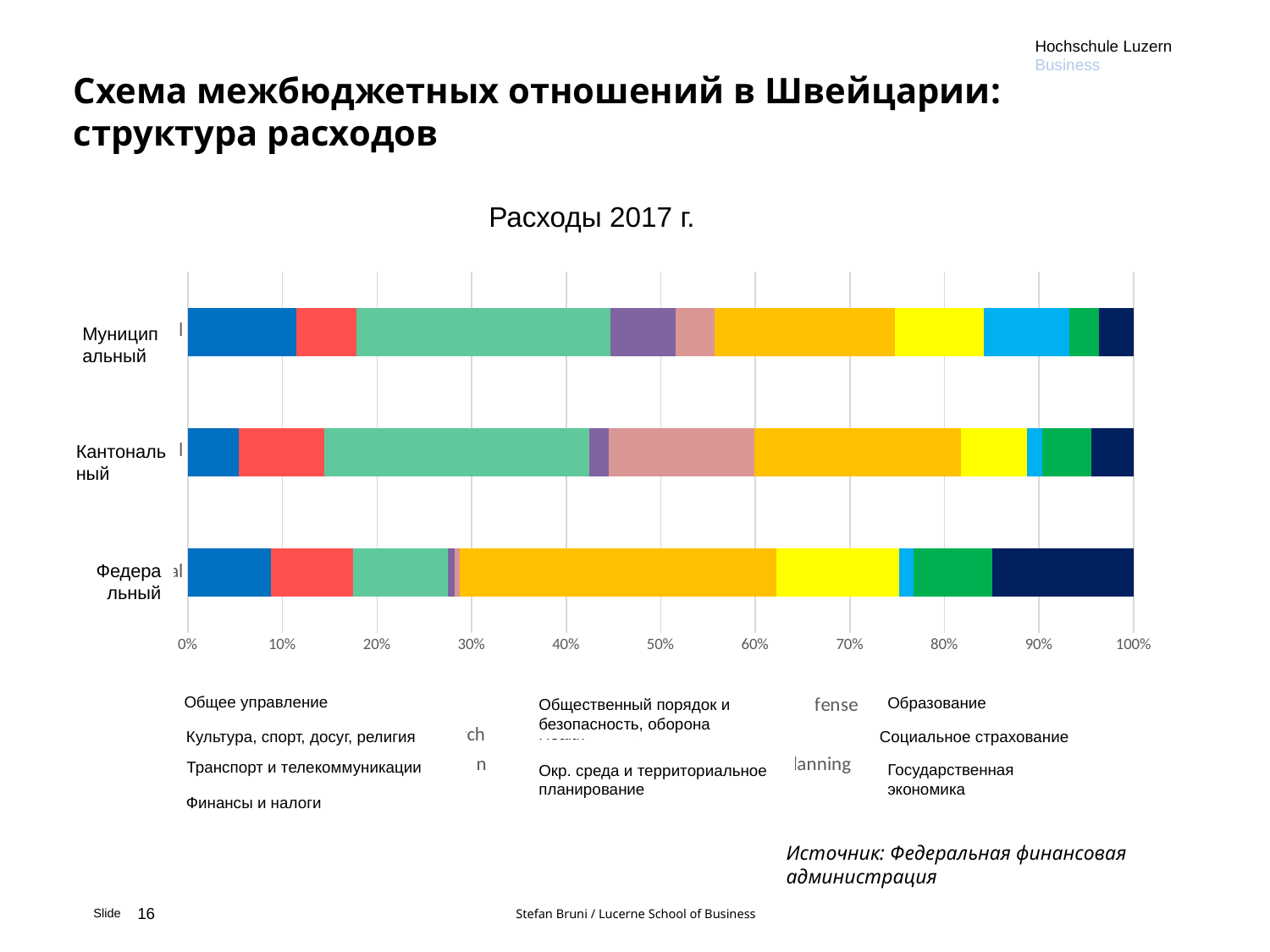
Which bar has the widest dark blue (rightmost) segment? Федеральный Is the width of the dark blue (rightmost) segment in the Федеральный bar greater or less than 10%? greater Is the width of the orange segment in the Федеральный bar greater or less than 20%? greater Is the width of the red segment in the Муниципальный bar greater or less than 10%? less Which bar has the widest orange segment? Федеральный What is the highest value shown on the horizontal axis? 100% Which bar has the widest pink segment? Кантональный How many budget levels (bars) are shown in the chart? 3 What kind of chart is shown on the slide? Stacked bar chart What is the title of the chart? Расходы 2017 г.